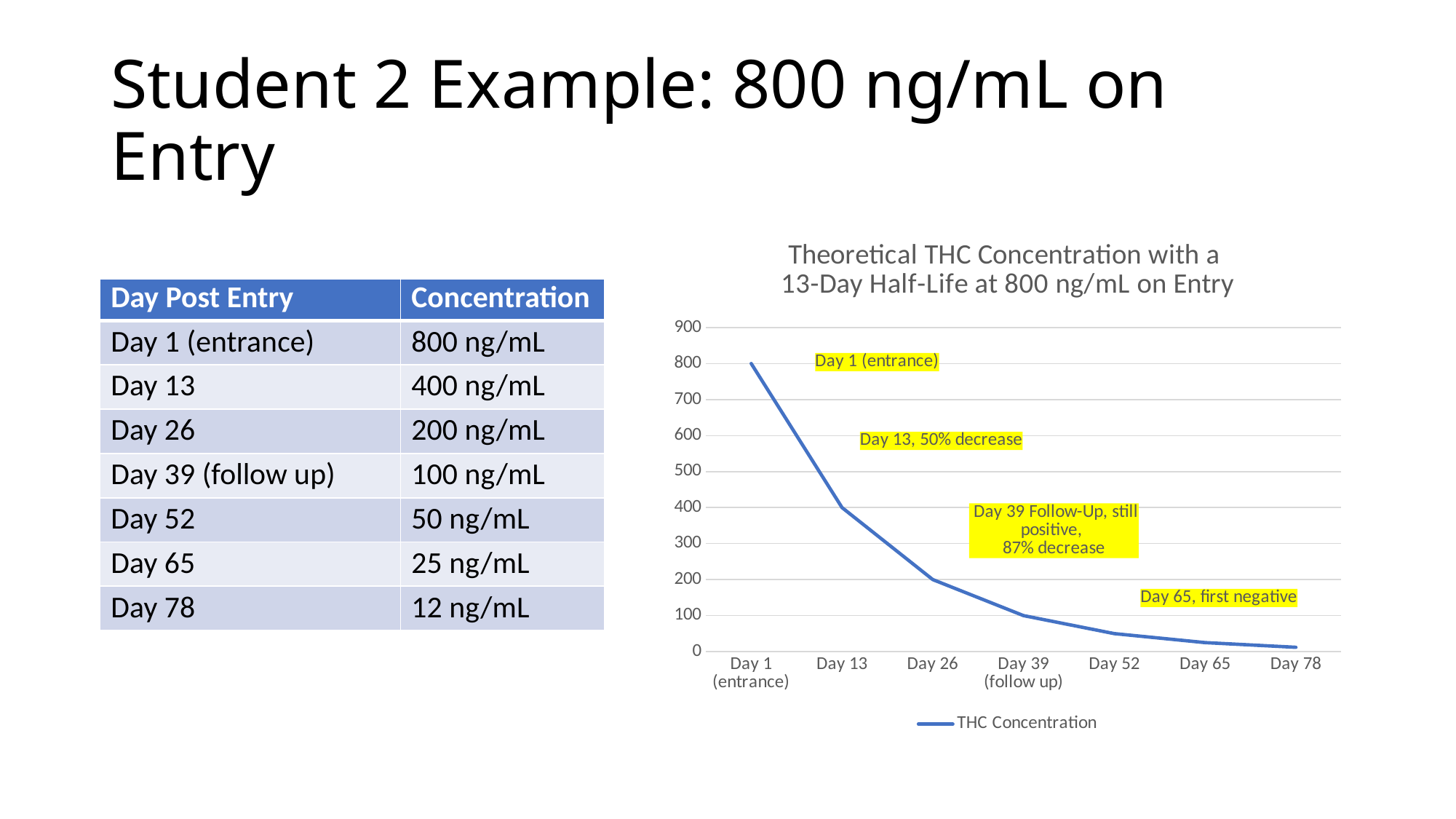
What is the THC concentration on Day 13? 400 ng/mL What is the THC concentration on Day 78? 12 ng/mL Which day has the highest THC concentration? Day 1 (entrance) Does the THC concentration rise or fall from Day 1 to Day 78? Fall What is the THC concentration on Day 39 (follow up)? 100 ng/mL Is the THC concentration on Day 52 greater or less than 100? less Which day has the lowest THC concentration? Day 78 What is the THC concentration on Day 1 (entrance)? 800 ng/mL How many days (data points) are plotted on the x axis? 7 Which is larger, the THC concentration on Day 26 or on Day 52? Day 26 What is the difference in THC concentration between Day 1 (entrance) and Day 13? 400 ng/mL What kind of chart is shown on the slide? Line chart